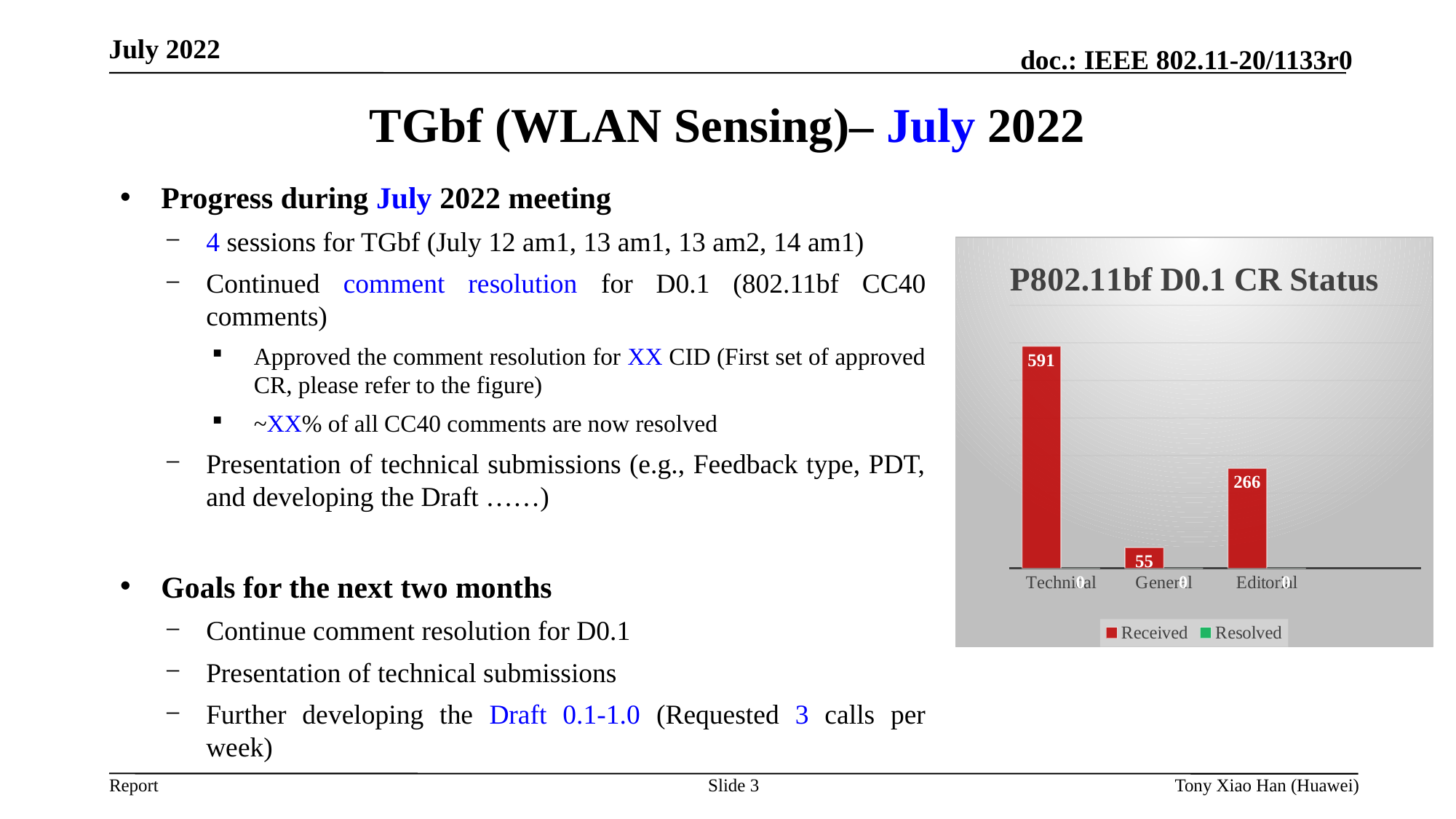
Which has a larger Received value, General or Editorial? Editorial What is the title of the chart on the slide? P802.11bf D0.1 CR Status What is the Received value for General comments? 55 Which category has the highest Received value? Technical How many categories are shown on the x axis of the chart? 3 What is the Received value for Editorial comments? 266 How many series does the chart legend list? 2 What is the Received value for Technical comments? 591 What are the series names listed in the chart legend? Received, Resolved What type of chart is shown on the slide? bar chart Which category has the lowest Received value? General What is the difference between the Received values for Technical and Editorial? 325